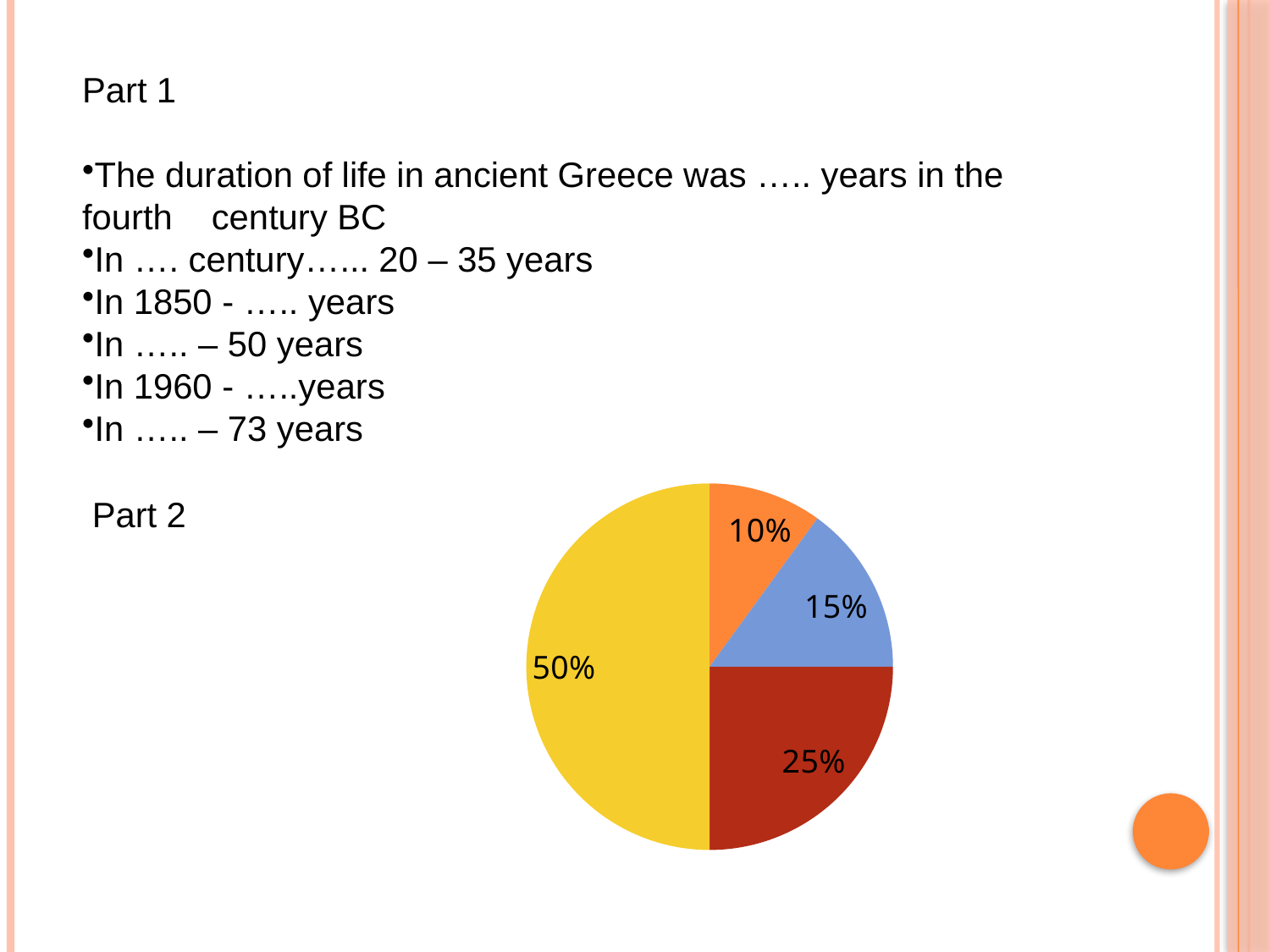
What share of the pie does the yellow slice represent? 50% What share of the pie does the blue slice represent? 15% What is the difference between the largest slice and the smallest slice of the pie chart? 40% What share of the pie does the orange slice represent? 10% How many slices does the pie chart have? 4 What is the difference between the 25% slice and the 15% slice of the pie chart? 10% What is the largest share shown in the pie chart? 50% Which slice is larger in the pie chart, the blue slice or the dark red slice? the dark red slice What kind of chart is shown on the slide? pie chart What is the smallest share shown in the pie chart? 10% What do the four slices of the pie chart add up to? 100%